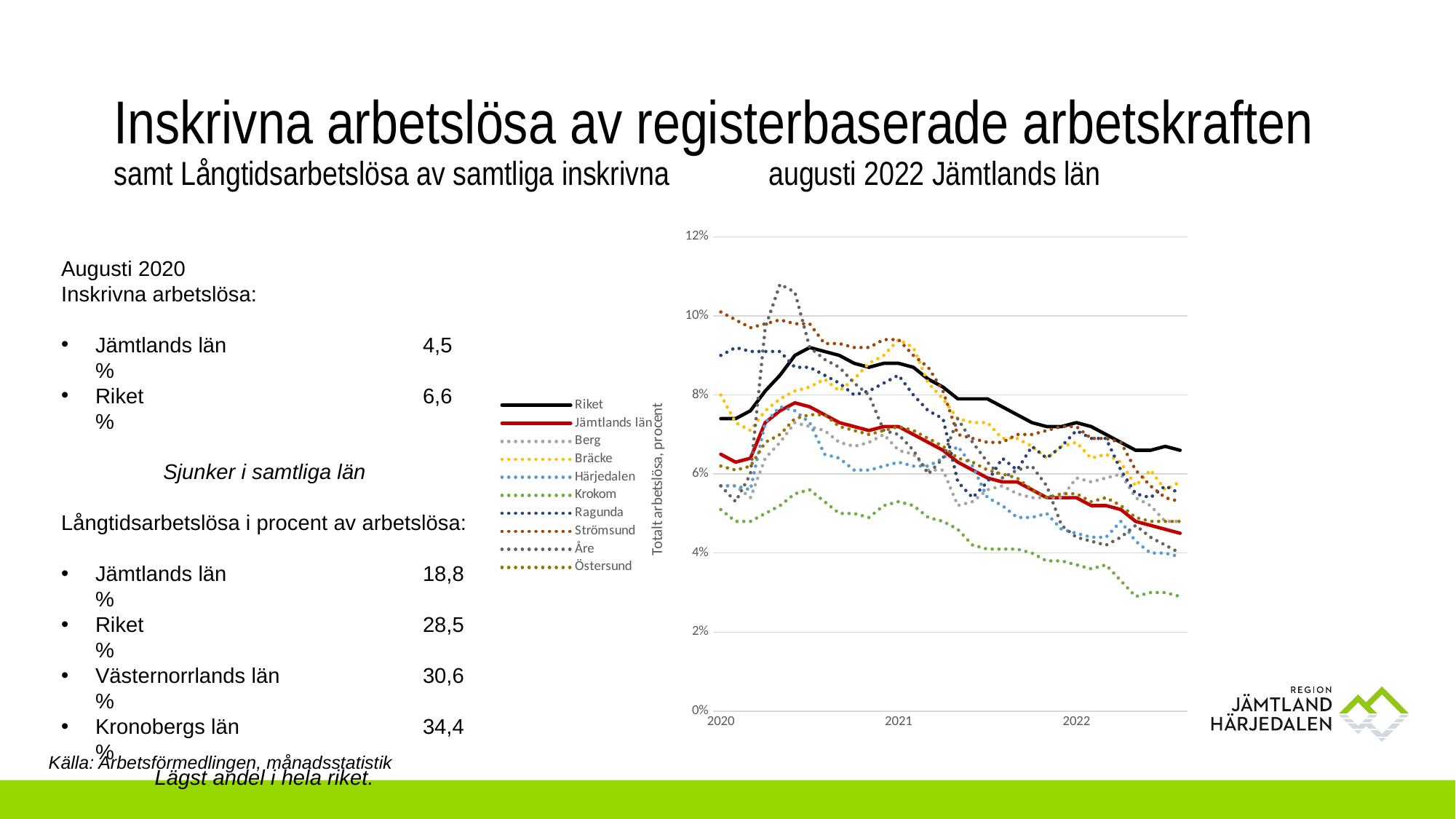
How many series does the chart legend list? 10 At its peak, is the value for Åre greater or less than 10%? greater At the end of the period, is the value for Riket greater or less than 6%? greater Does the Riket line rise or fall from 2021 to 2022? fall Which series has the highest value at the end of the period shown in the chart? Riket At the end of the period, is the value for Jämtlands län greater or less than 6%? less Which series in the chart is drawn as a solid red line? Jämtlands län What kind of chart is shown on the slide? line chart Which series has the lowest value at the end of the period shown in the chart? Krokom At the end of the period, which is larger: the value for Riket or the value for Jämtlands län? Riket What is the title of the vertical axis of the chart? Totalt arbetslösa, procent